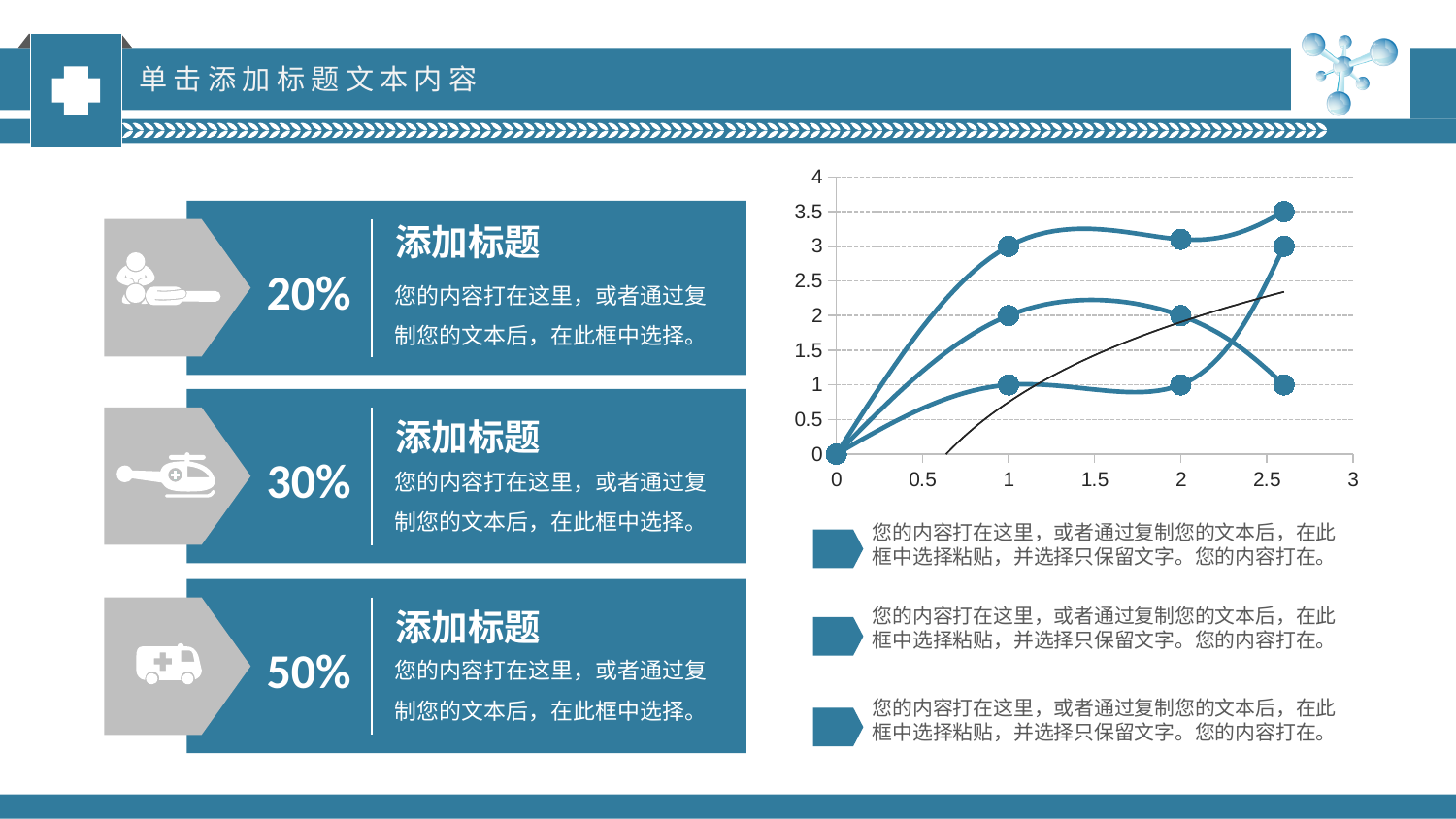
What is the y value of the highest plotted point on the chart? 3.5 At x = 1, what is the y value of the topmost plotted point? 3 What kind of chart is shown on the right side of the slide? line chart What is the highest value labelled on the horizontal axis of the chart? 3 At x = 1, which is larger: the topmost point or the lowest point? the topmost point At x = 2, is the lowest plotted point greater or less than 1.5? less At x = 1, what is the y value of the lowest plotted point? 1 Does the topmost line on the chart generally rise or fall from x = 0 to its last point? rise What is the highest value labelled on the vertical axis of the chart? 4 How many plotted markers (data points) are shown on the chart? 10 Is the highest plotted point on the chart greater or less than 3? greater How many tick labels are shown on the horizontal axis of the chart? 7